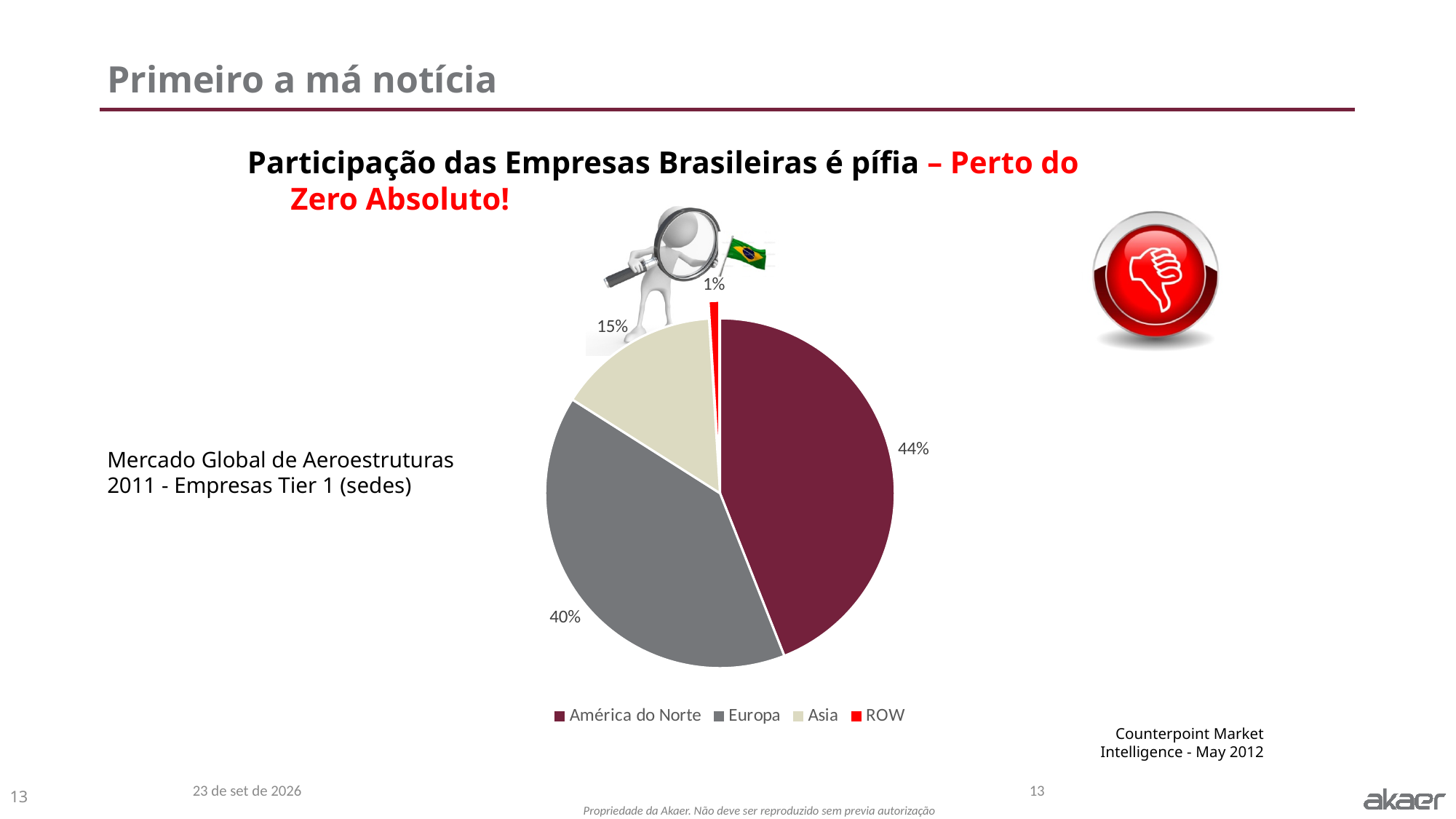
What share of the pie does Europa have? 40% What kind of chart is shown on the slide? pie chart Which colour represents ROW in the pie chart? red What share of the pie does Asia have? 15% Which category has the largest share of the pie? América do Norte What is the difference in percentage points between América do Norte and Europa? 4 Which has a larger share, Europa or Asia? Europa What share of the pie does ROW have? 1% Which category has the smallest share of the pie? ROW What is the difference in percentage points between Asia and ROW? 14 What share of the pie does América do Norte have? 44% How many categories does the legend list? 4